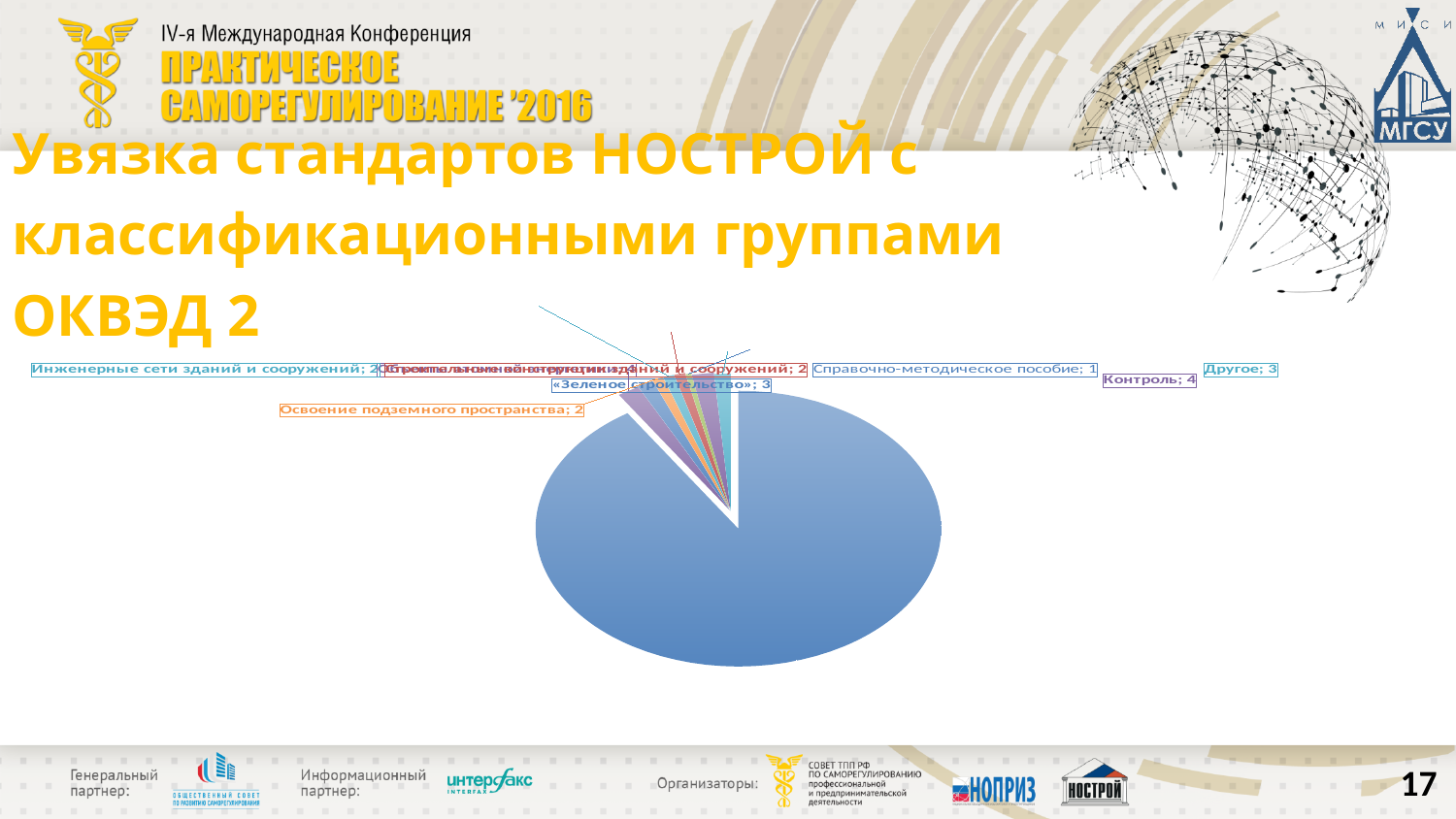
What kind of chart is shown on the slide? pie chart What is the difference between the values for Другое and Инженерные сети зданий и сооружений? 1 What is the value for Другое in the pie chart? 3 Which is larger in the pie chart, «Зеленое строительство» or Освоение подземного пространства? «Зеленое строительство» What is the value for Освоение подземного пространства in the pie chart? 2 What is the difference between the values for Контроль and Справочно-методическое пособие? 3 What is the value for «Зеленое строительство» in the pie chart? 3 What colour is the largest slice of the pie chart? blue What is the value for Контроль in the pie chart? 4 What is the value for Справочно-методическое пособие in the pie chart? 1 Which is larger in the pie chart, Контроль or Другое? Контроль What is the value for Инженерные сети зданий и сооружений in the pie chart? 2